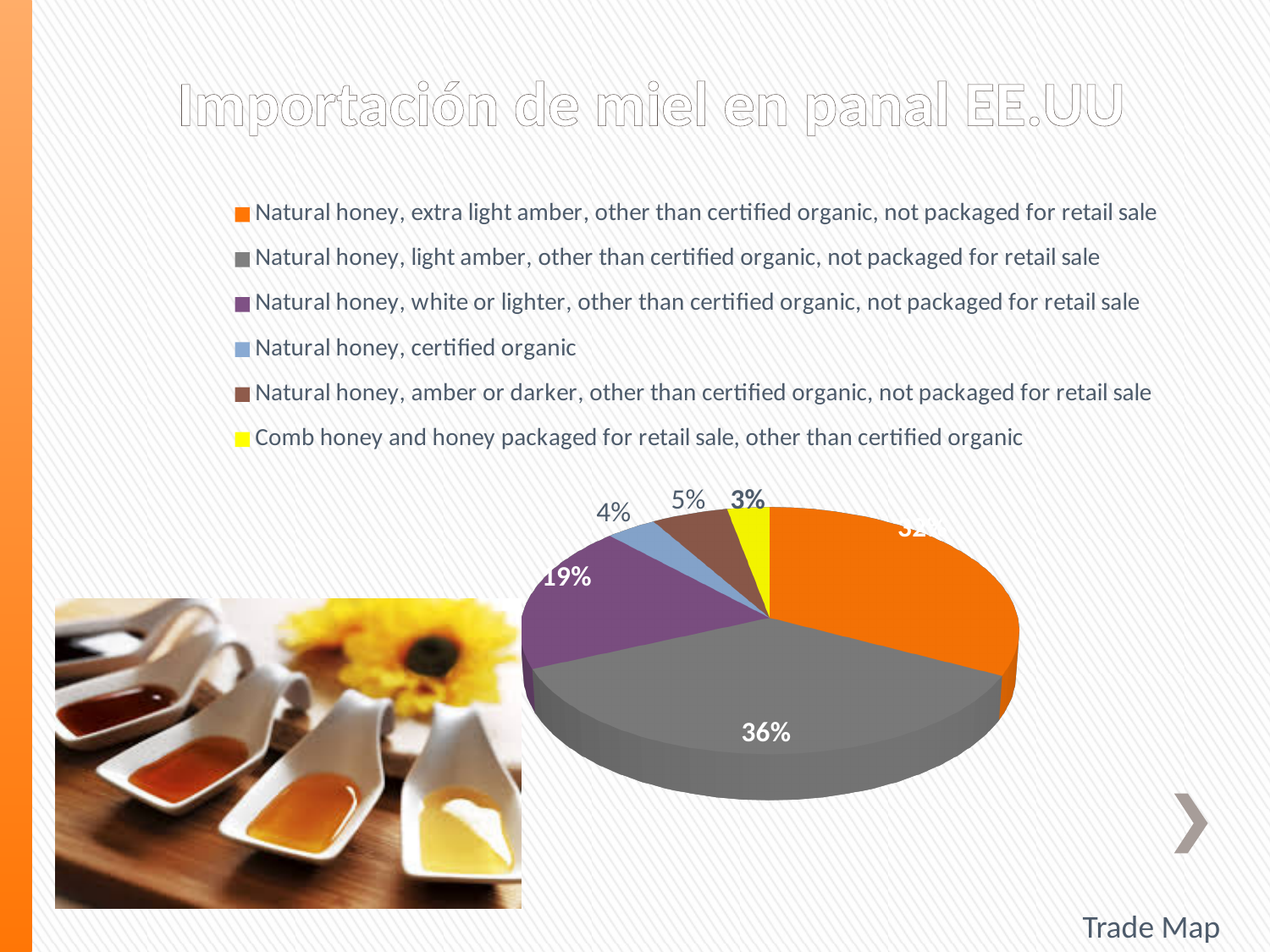
What percentage is shown for 'Natural honey, amber or darker, other than certified organic, not packaged for retail sale'? 5% Which category has the smallest slice of the pie? Comb honey and honey packaged for retail sale, other than certified organic Which slice is larger: 'Natural honey, amber or darker' or 'Natural honey, certified organic'? Natural honey, amber or darker What colour represents 'Natural honey, certified organic' in the legend? Blue What share of the pie does 'Natural honey, light amber, other than certified organic, not packaged for retail sale' represent? 36% What is the difference in percentage points between the light amber slice (36%) and the white or lighter slice (19%)? 17 What percentage is shown for 'Natural honey, certified organic'? 4% What kind of chart is shown on the slide? Pie chart How many categories does the legend list? 6 What is the title of the slide? Importación de miel en panal EE.UU What percentage is shown for 'Comb honey and honey packaged for retail sale, other than certified organic'? 3% What percentage is shown for 'Natural honey, white or lighter, other than certified organic, not packaged for retail sale'? 19%